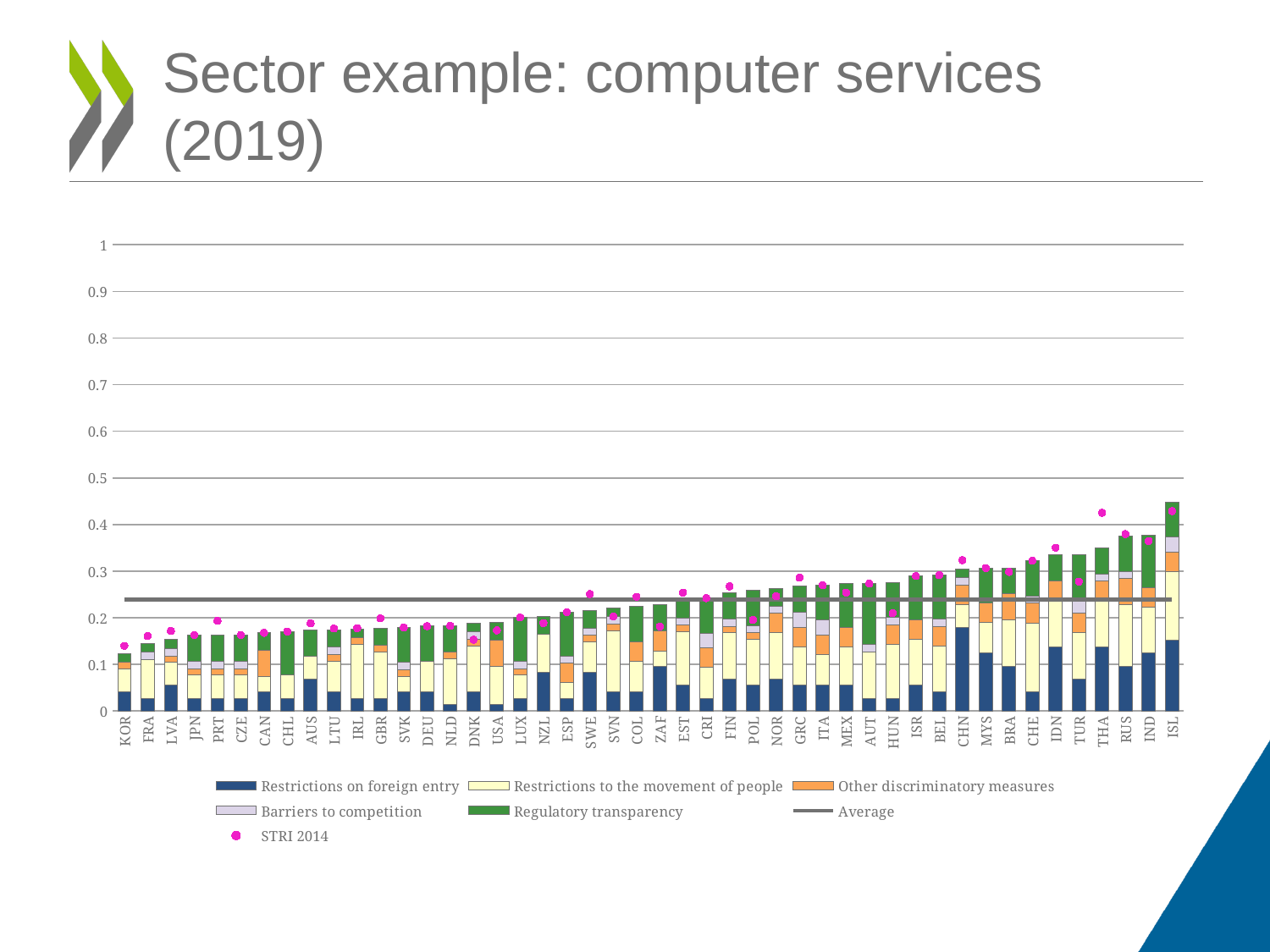
Is the total bar value for KOR greater or less than 0.2? less Is the total bar value for THA greater or less than 0.3? greater Which country has the lowest total stacked bar in the chart? KOR Do the total bar values generally rise or fall moving from left to right along the x axis? rise Which country has a larger total bar, ISL or KOR? ISL Which legend entry is represented by the green segments of the bars? Regulatory transparency How many countries are shown along the x axis of the chart? 46 What is the title of the slide containing the chart? Sector example: computer services (2019) Which country has the highest total stacked bar in the chart? ISL Is the total bar value for ISL greater or less than 0.4? greater How many entries does the chart legend list? 7 What kind of chart is shown on the slide? Stacked bar chart